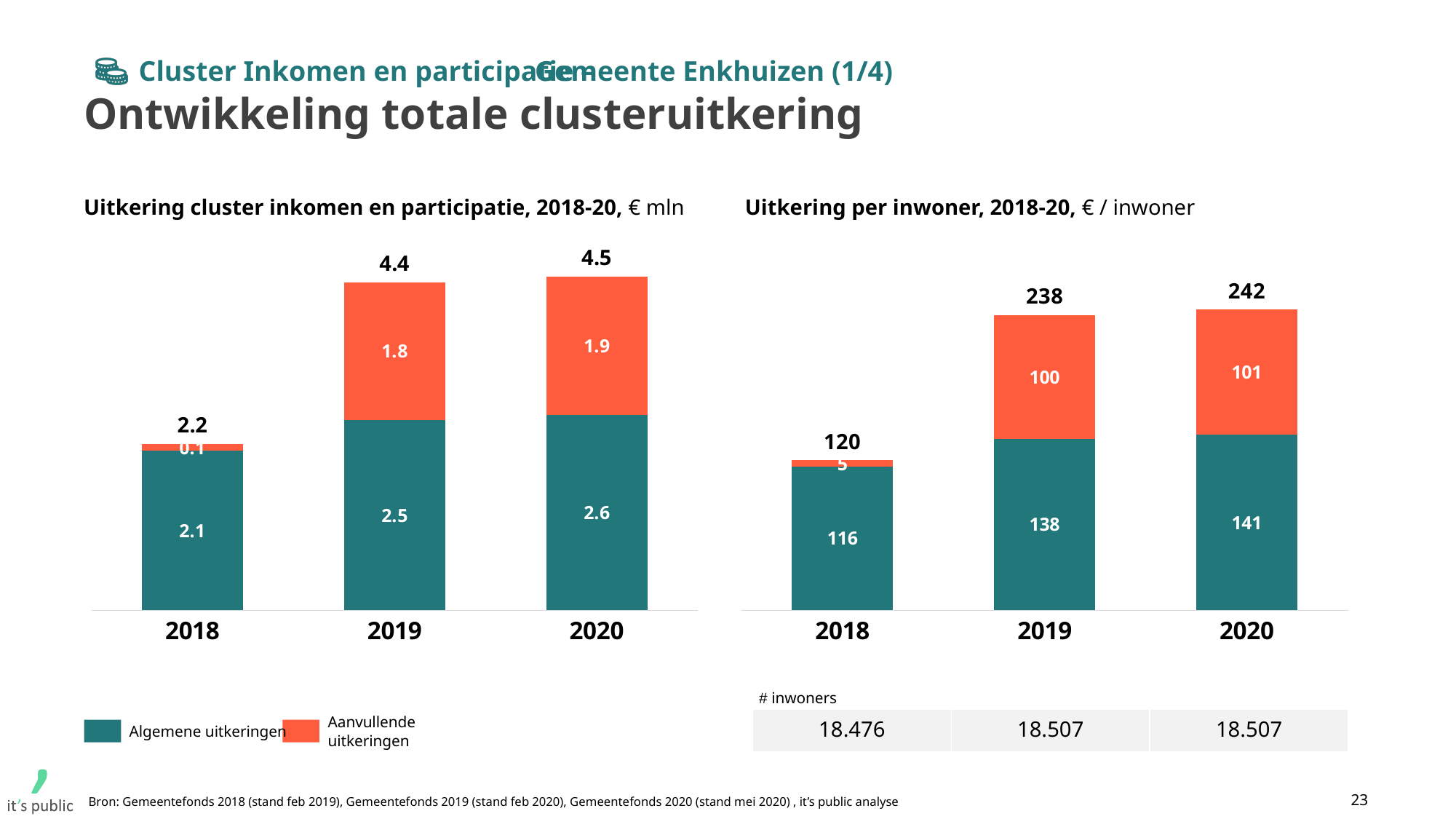
In the left chart 'Uitkering cluster inkomen en participatie', what is the value of Aanvullende uitkeringen for 2020? 1.9 What kind of chart is the left chart 'Uitkering cluster inkomen en participatie'? Stacked bar chart In the left chart 'Uitkering cluster inkomen en participatie', what is the total of the stacked bar for 2018? 2.2 In the right chart 'Uitkering per inwoner', which year has the lowest total? 2018 In the left chart 'Uitkering cluster inkomen en participatie', what is the difference between the total for 2020 and the total for 2018? 2.3 In the right chart 'Uitkering per inwoner', what is the value of Algemene uitkeringen for 2020? 141 In the right chart 'Uitkering per inwoner', what is the value of Aanvullende uitkeringen for 2019? 100 In the right chart 'Uitkering per inwoner', what is the total of the stacked bar for 2019? 238 In the right chart 'Uitkering per inwoner', what is the difference between the Algemene uitkeringen value for 2020 and for 2018? 25 How many series does the legend list for the charts on this slide? 2 In the left chart 'Uitkering cluster inkomen en participatie', what is the value of Algemene uitkeringen for 2019? 2.5 In the left chart 'Uitkering cluster inkomen en participatie', which year has the highest total? 2020